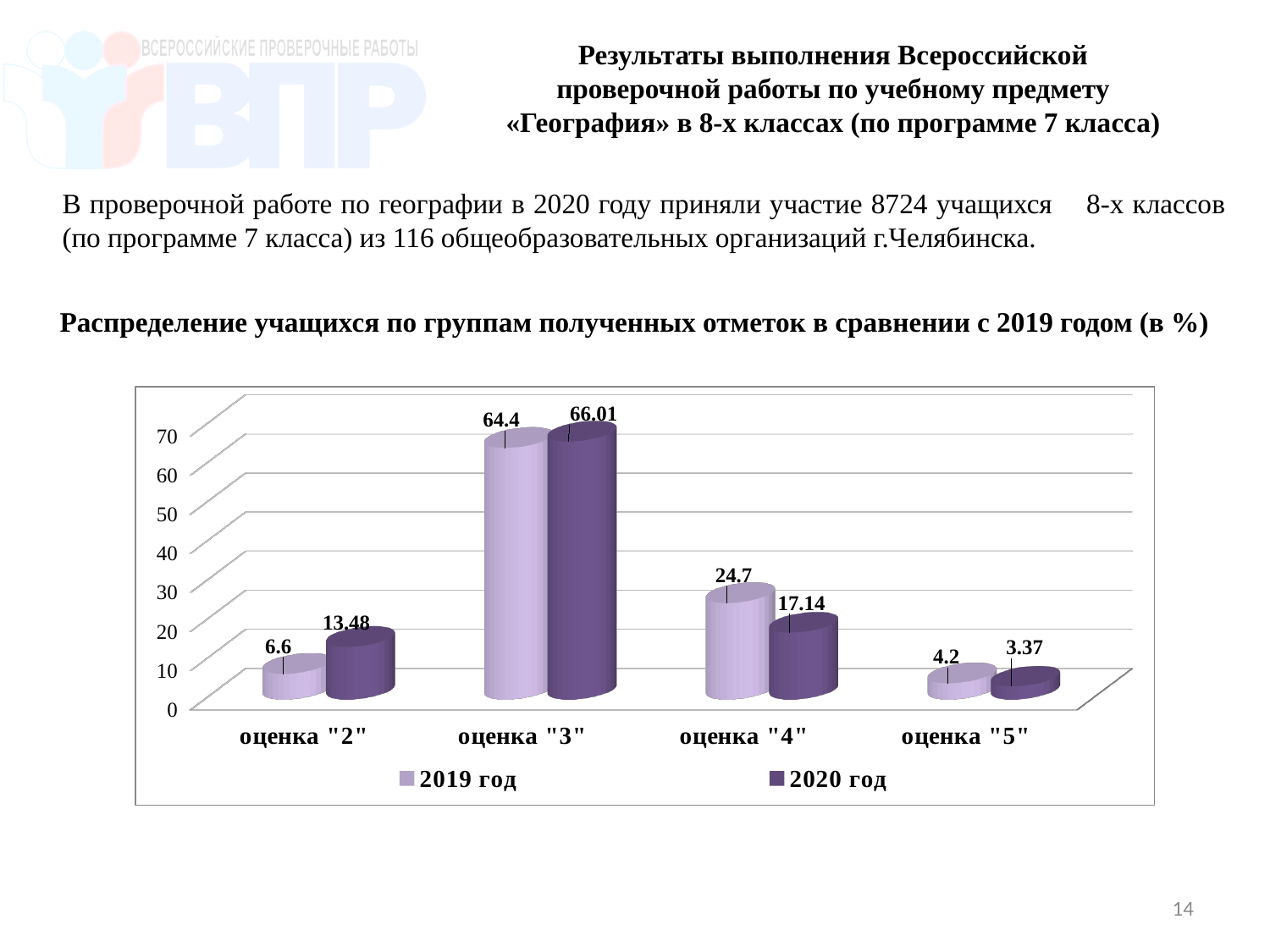
Which is larger for оценка "2": the 2019 год value or the 2020 год value? 2020 год What is the value for оценка "2" in the 2019 год series? 6.6 What is the value for оценка "5" in the 2019 год series? 4.2 What are the two series named in the legend? 2019 год and 2020 год What is the difference between the 2019 год and 2020 год values for оценка "4"? 7.56 How many categories are shown on the x axis? 4 What kind of chart is shown on the slide? bar chart How many series does the legend list? 2 What is the value for оценка "4" in the 2020 год series? 17.14 Which category has the lowest value in the 2019 год series? оценка "5" What is the value for оценка "3" in the 2020 год series? 66.01 Which category has the highest value in the 2020 год series? оценка "3"